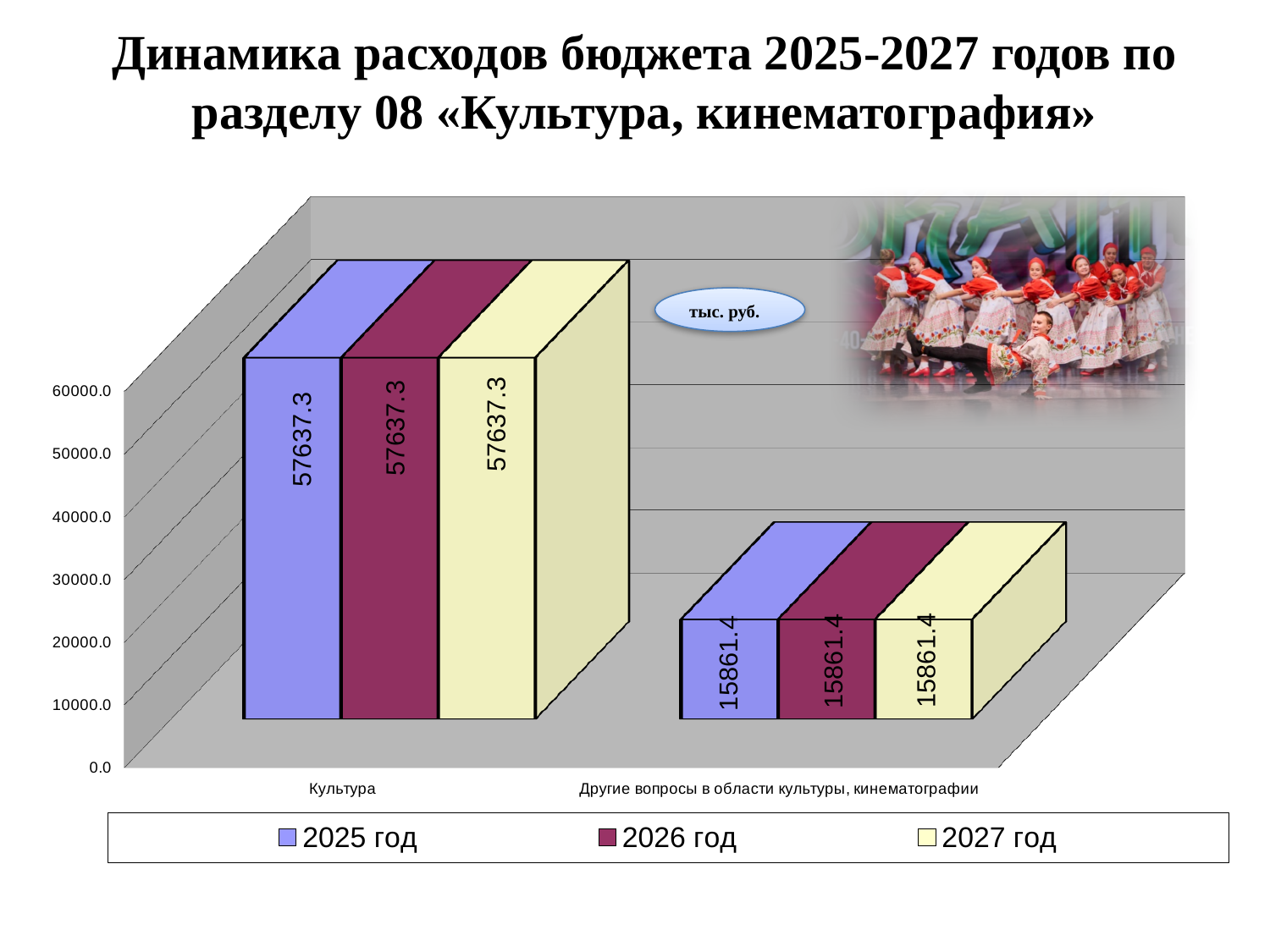
Which is larger in 2025 год: Культура or Другие вопросы в области культуры, кинематографии? Культура What is the difference between Культура and Другие вопросы в области культуры, кинематографии in 2026 год? 41775.9 Which category has the lowest value in 2027 год? Другие вопросы в области культуры, кинематографии How many series does the legend list? 3 What unit is indicated in the callout on the chart? тыс. руб. How many categories are shown on the x axis? 2 Is the value for Культура in 2027 год greater or less than 50000.0? greater What is the value for Культура in 2026 год? 57637.3 What is the value for Культура in 2025 год? 57637.3 Which category has the highest value in 2025 год? Культура What kind of chart is shown on the slide? bar chart What is the value for Другие вопросы в области культуры, кинематографии in 2027 год? 15861.4